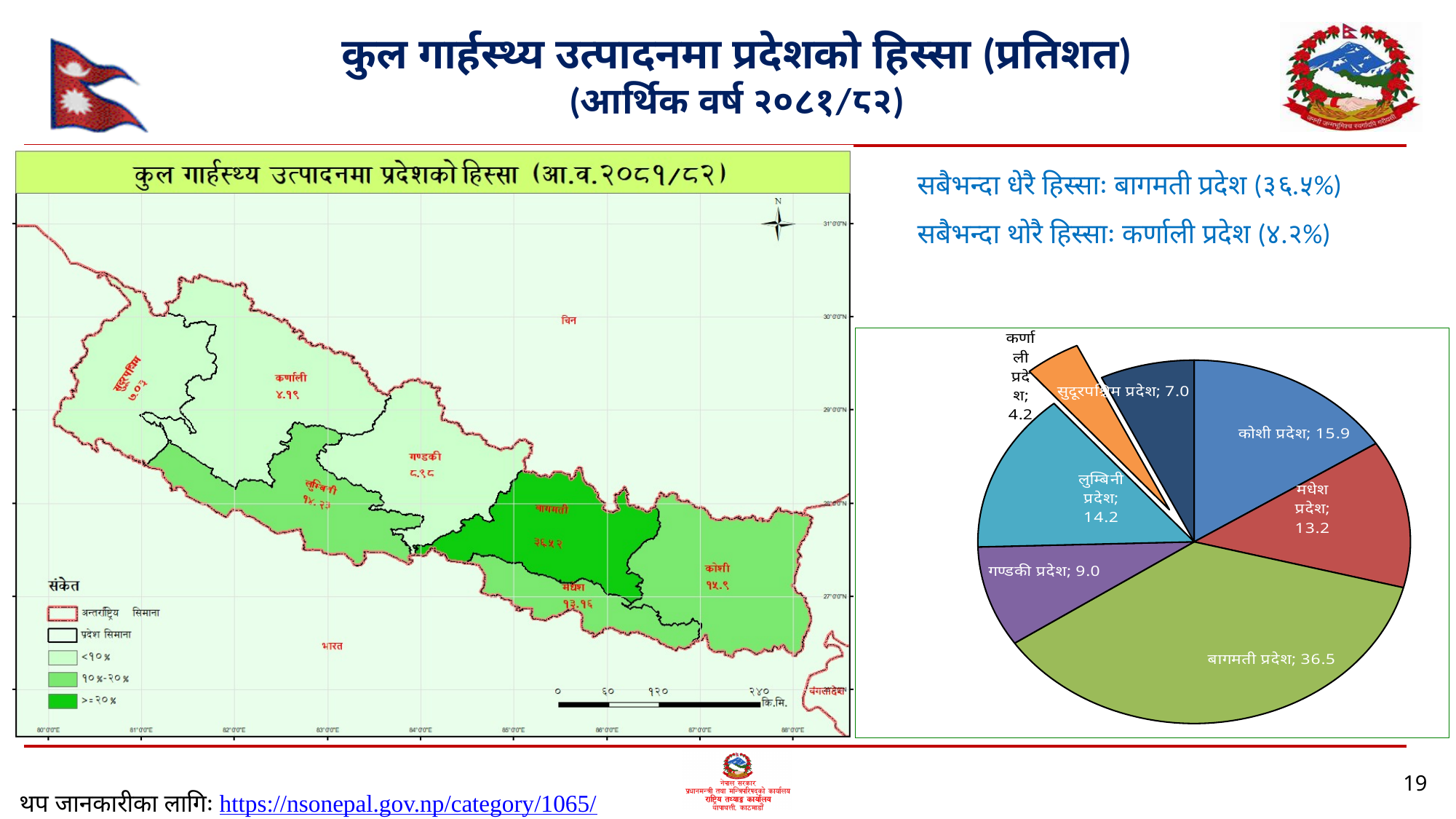
In the pie chart, which slice is pulled out (exploded) from the rest of the pie? कर्णाली प्रदेश In the pie chart, what is the difference between the values for बागमती प्रदेश and कोशी प्रदेश? 20.6 What kind of chart is shown on the right side of the slide? pie chart How many slices does the pie chart have? 7 In the pie chart, what is the value shown for सुदूरपश्चिम प्रदेश? 7.0 In the pie chart, what is the value shown for लुम्बिनी प्रदेश? 14.2 Which province has the largest slice in the pie chart? बागमती प्रदेश In the pie chart, what is the value shown for गण्डकी प्रदेश? 9.0 In the pie chart, what is the value shown for कोशी प्रदेश? 15.9 In the pie chart, what is the value shown for बागमती प्रदेश? 36.5 Which province has the smallest slice in the pie chart? कर्णाली प्रदेश In the pie chart, which is larger: the value for मधेश प्रदेश or the value for लुम्बिनी प्रदेश? लुम्बिनी प्रदेश